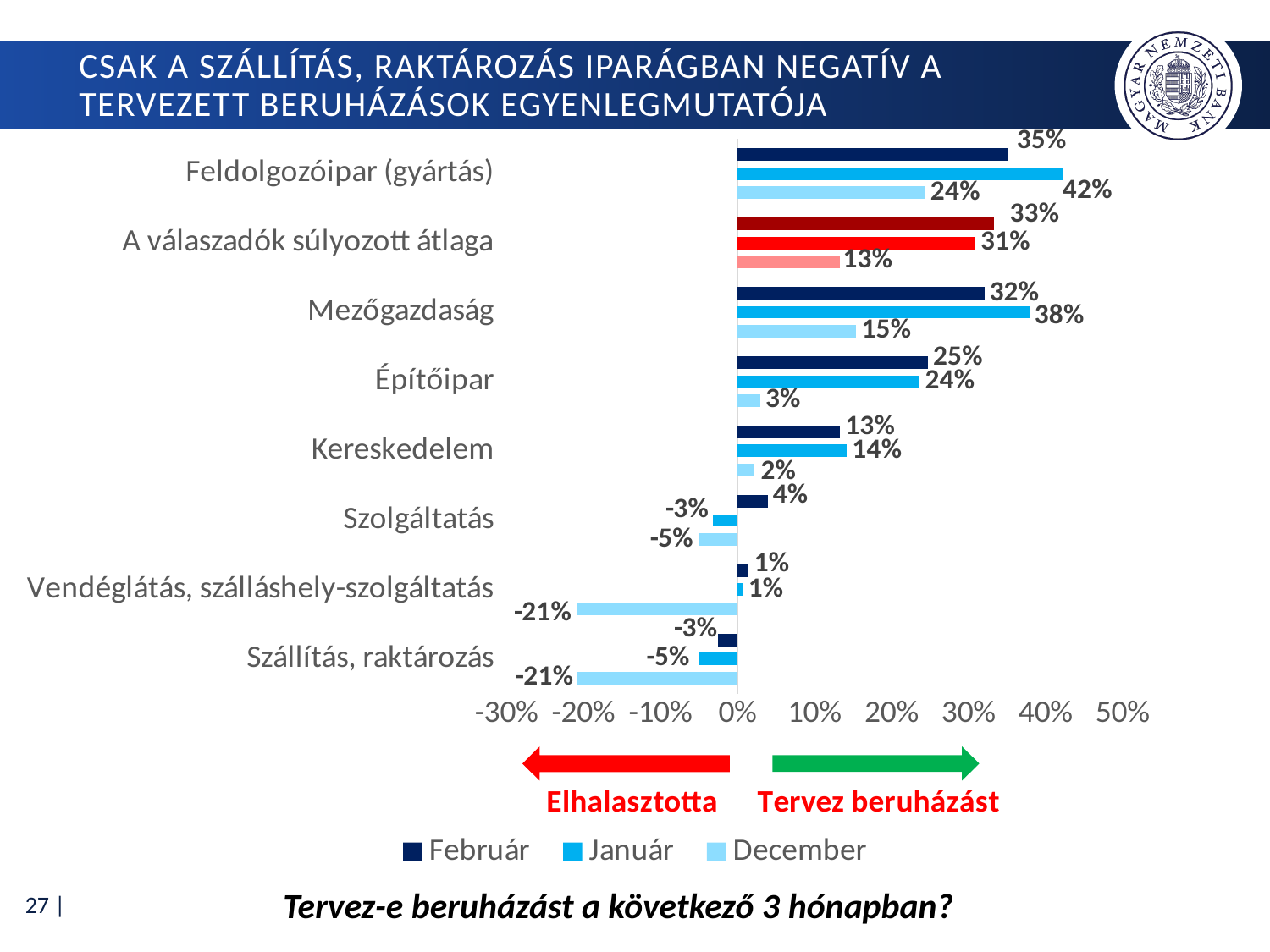
Which category has the lowest Február value? Szállítás, raktározás What kind of chart is shown on the slide? Bar chart What is the Január value for Mezőgazdaság? 38% What is the December value for A válaszadók súlyozott átlaga? 13% What is the Február value for Feldolgozóipar (gyártás)? 35% What is the Február value for Szállítás, raktározás? -3% What is the difference between the Január and December values for Feldolgozóipar (gyártás)? 18 percentage points Which series is shown in the lightest blue colour in the legend? December Which is larger for Építőipar, the Február value or the Január value? Február How many series does the legend list? 3 Which category has the highest Január value? Feldolgozóipar (gyártás) How many categories are shown on the chart? 8